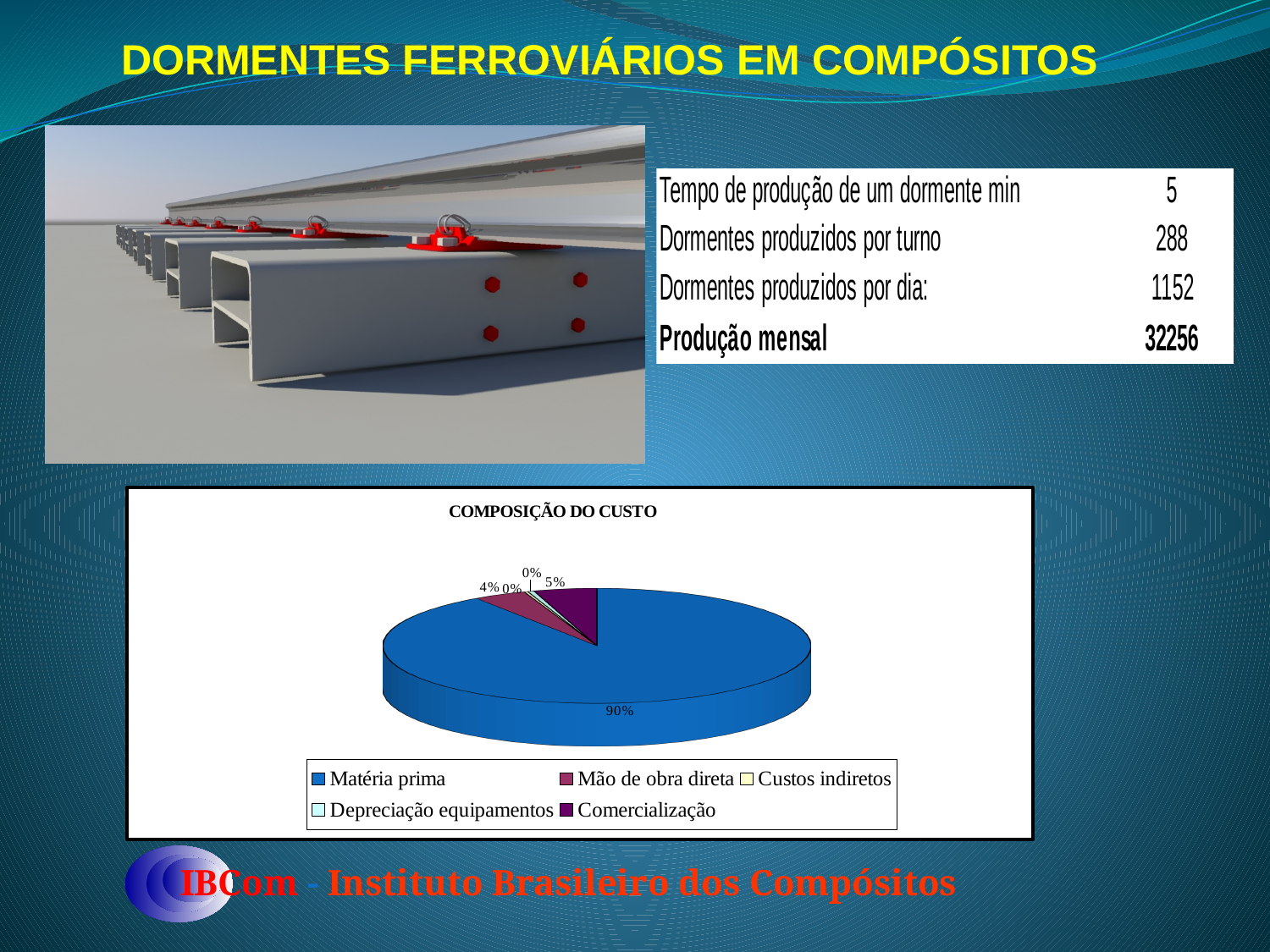
Which category has the largest share of the pie chart? Matéria prima What is the difference in percentage points between the share for Matéria prima and the share for Comercialização? 85 What kind of chart is shown under the title "COMPOSIÇÃO DO CUSTO"? pie chart What share of the pie does Comercialização represent? 5% What share of the pie does Mão de obra direta represent? 4% Is the share for Matéria prima greater or less than 50%? greater How many categories does the legend of the pie chart list? 5 What is the title of the pie chart on the slide? COMPOSIÇÃO DO CUSTO Which is larger in the pie chart, the share for Comercialização or the share for Mão de obra direta? Comercialização What colour is the Matéria prima slice in the pie chart? blue What share of the pie does Matéria prima represent? 90%